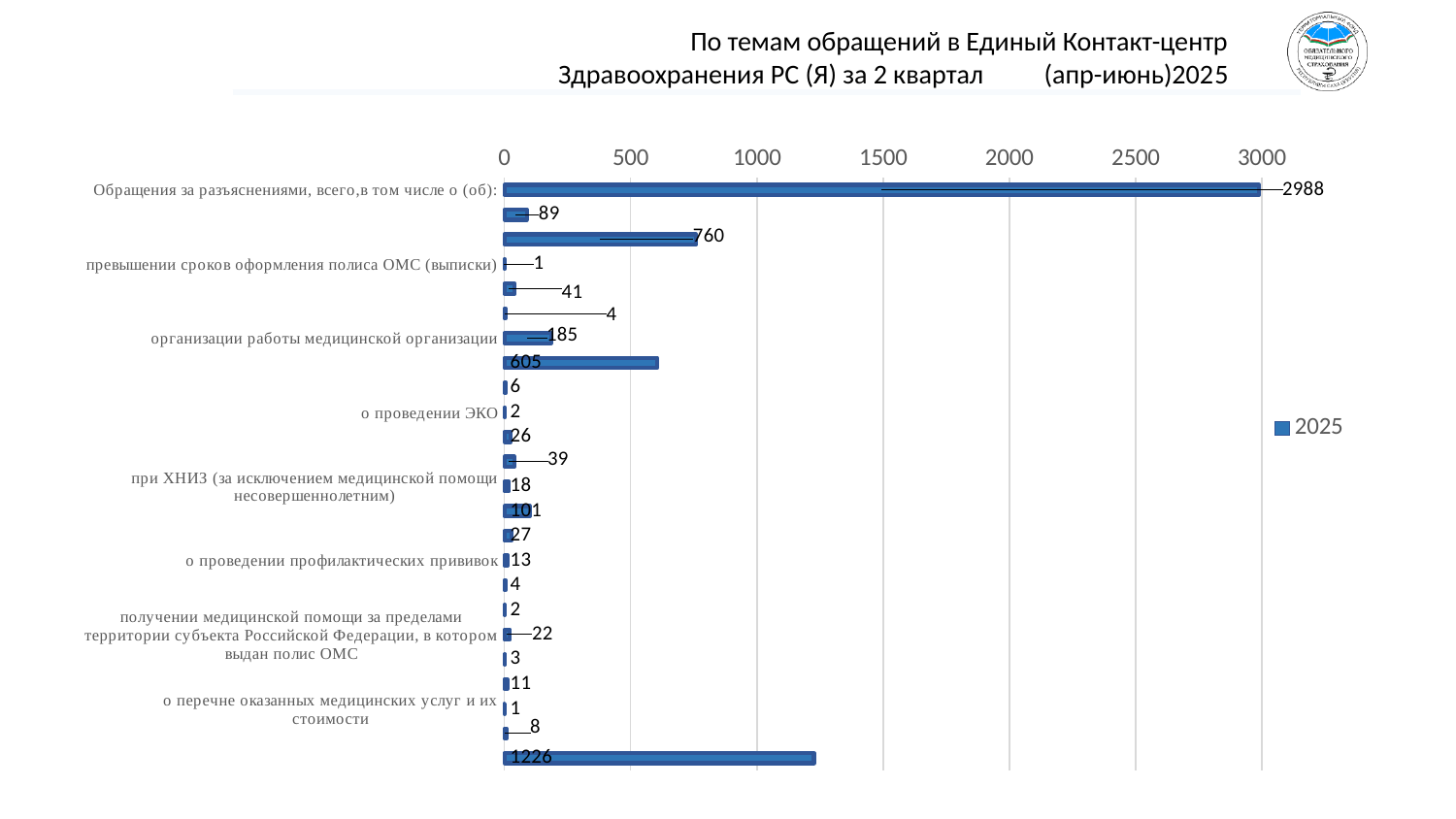
Is the value for "Обращения за разъяснениями, всего,в том числе о (об):" greater or less than 2500? greater How many series does the legend list? 1 Which category has the highest value? Обращения за разъяснениями, всего,в том числе о (об): What kind of chart is shown on the slide? bar chart What is the value for "Обращения за разъяснениями, всего,в том числе о (об):"? 2988 What is the difference between the values for "организации работы медицинской организации" and "о проведении профилактических прививок"? 172 What is the value for "о проведении профилактических прививок"? 13 What entry is shown in the chart legend? 2025 What is the value for "организации работы медицинской организации"? 185 What is the value for "получении медицинской помощи за пределами территории субъекта Российской Федерации, в котором выдан полис ОМС"? 22 What is the value for "при ХНИЗ (за исключением медицинской помощи несовершеннолетним)"? 18 Which is larger: the value for "получении медицинской помощи за пределами территории субъекта Российской Федерации, в котором выдан полис ОМС" or the value for "о проведении ЭКО"? получении медицинской помощи за пределами территории субъекта Российской Федерации, в котором выдан полис ОМС